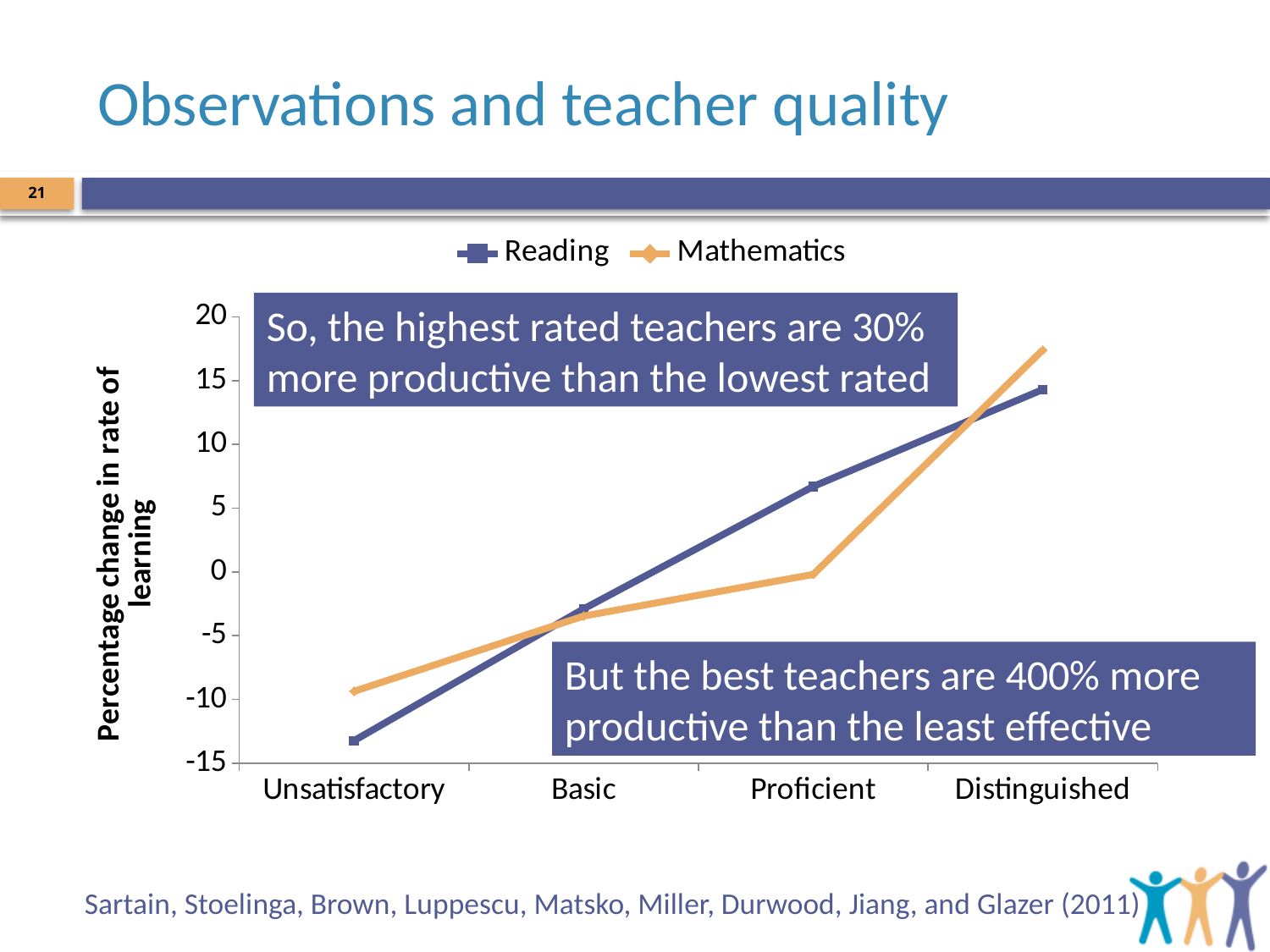
How many categories are shown on the x axis? 4 Is the Mathematics value for Distinguished greater or less than 15? greater At Proficient, which series has the larger value, Reading or Mathematics? Reading Do the Reading values rise or fall from Unsatisfactory to Distinguished? Rise Is the Reading value for Proficient greater or less than 5? greater What is the label of the vertical axis? Percentage change in rate of learning Is the Reading value for Unsatisfactory greater or less than -10? less Which series are listed in the legend? Reading and Mathematics What kind of chart is shown on the slide? Line chart For which category is the Reading value highest? Distinguished How many series does the legend list? 2 For which category is the Mathematics value lowest? Unsatisfactory